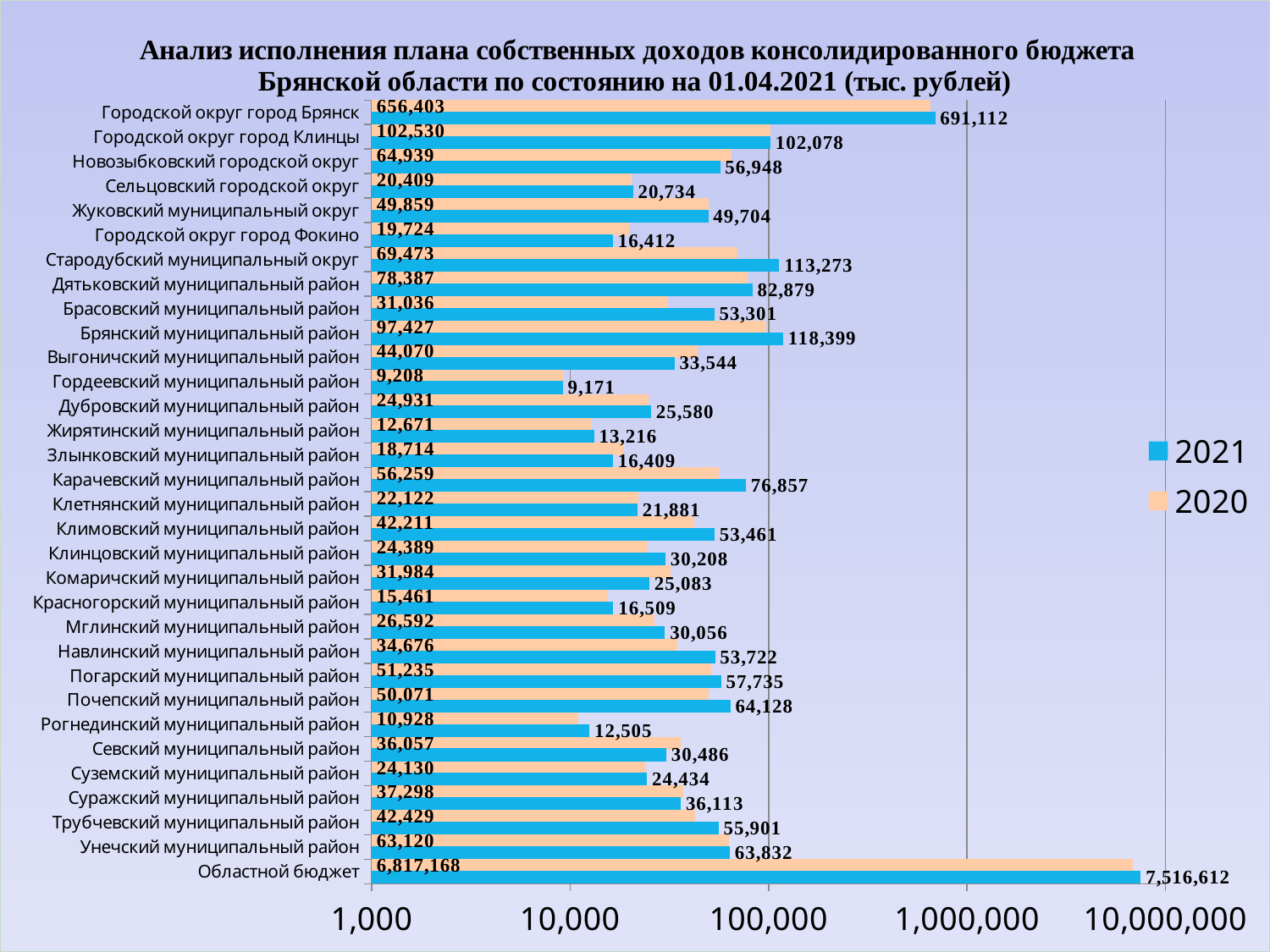
Which category has the lowest 2021 value? Гордеевский муниципальный район Which category has the highest 2021 value? Областной бюджет What is the 2021 value for Стародубский муниципальный округ? 113,273 How many series does the legend list? 2 What is the 2021 value for Городской округ город Брянск? 691,112 How many categories are shown on the chart? 32 Which is larger for Выгоничский муниципальный район, the 2021 value or the 2020 value? 2020 What is the difference between the 2021 and 2020 values for Брянский муниципальный район? 20,972 What is the 2020 value for Областной бюджет? 6,817,168 What kind of chart is shown on the slide? bar chart Is the 2021 value for Городской округ город Клинцы greater or less than 100,000? greater Which colour represents the 2020 series in the legend? orange